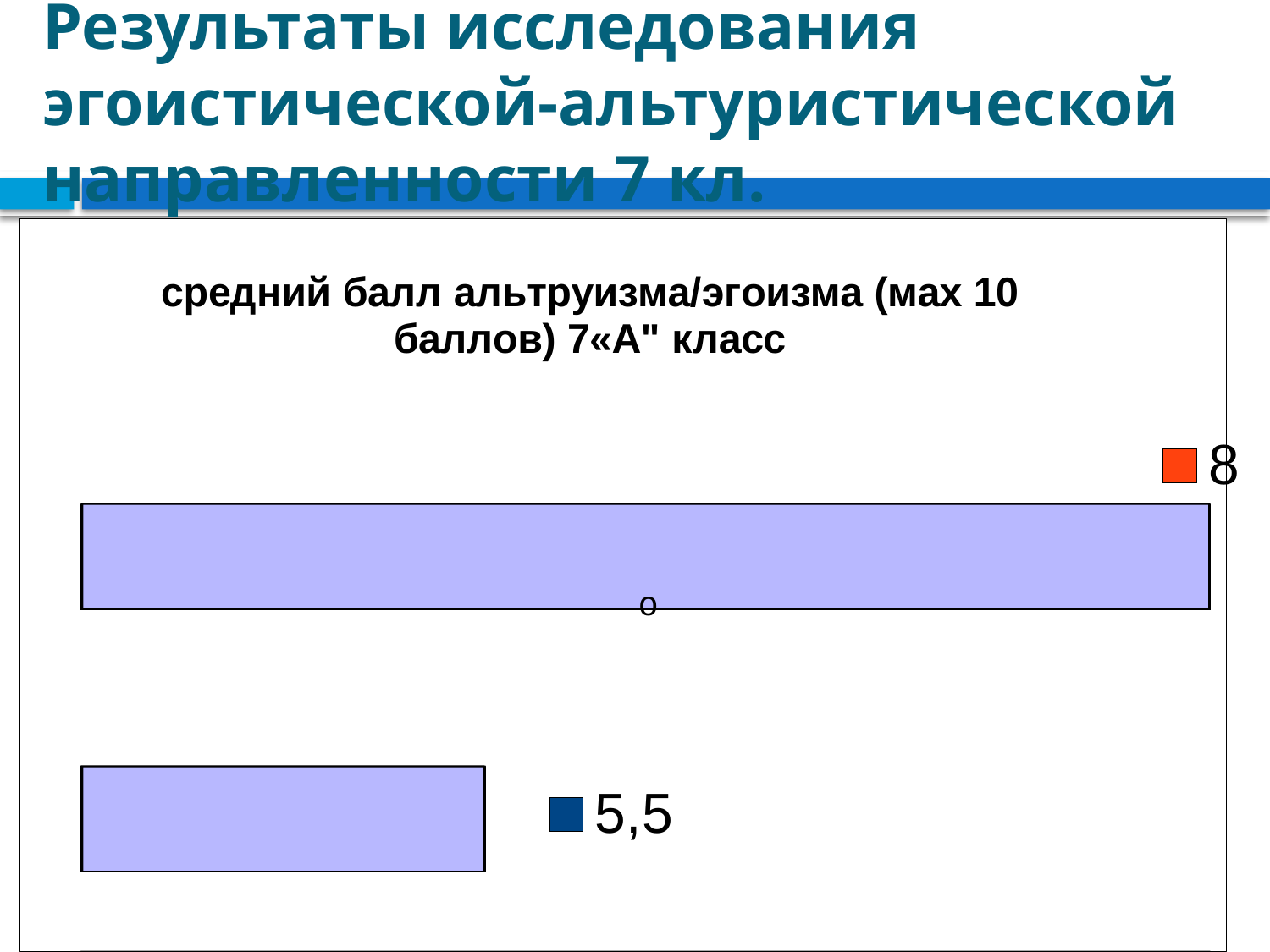
Which bar has the higher value, the top bar or the bottom bar? the top bar What is the lowest value shown in the chart? 5,5 What kind of chart is shown on the slide? bar chart Which class does the chart title refer to? 7«А" класс What is the highest value shown in the chart? 8 What is the difference between the two labelled values, 8 and 5,5? 2,5 What is the maximum possible score mentioned in the chart title? 10 баллов How many bars are plotted in the chart? 2 What value is labelled for the bottom (shorter) bar? 5,5 What value is labelled for the top (longer) bar? 8